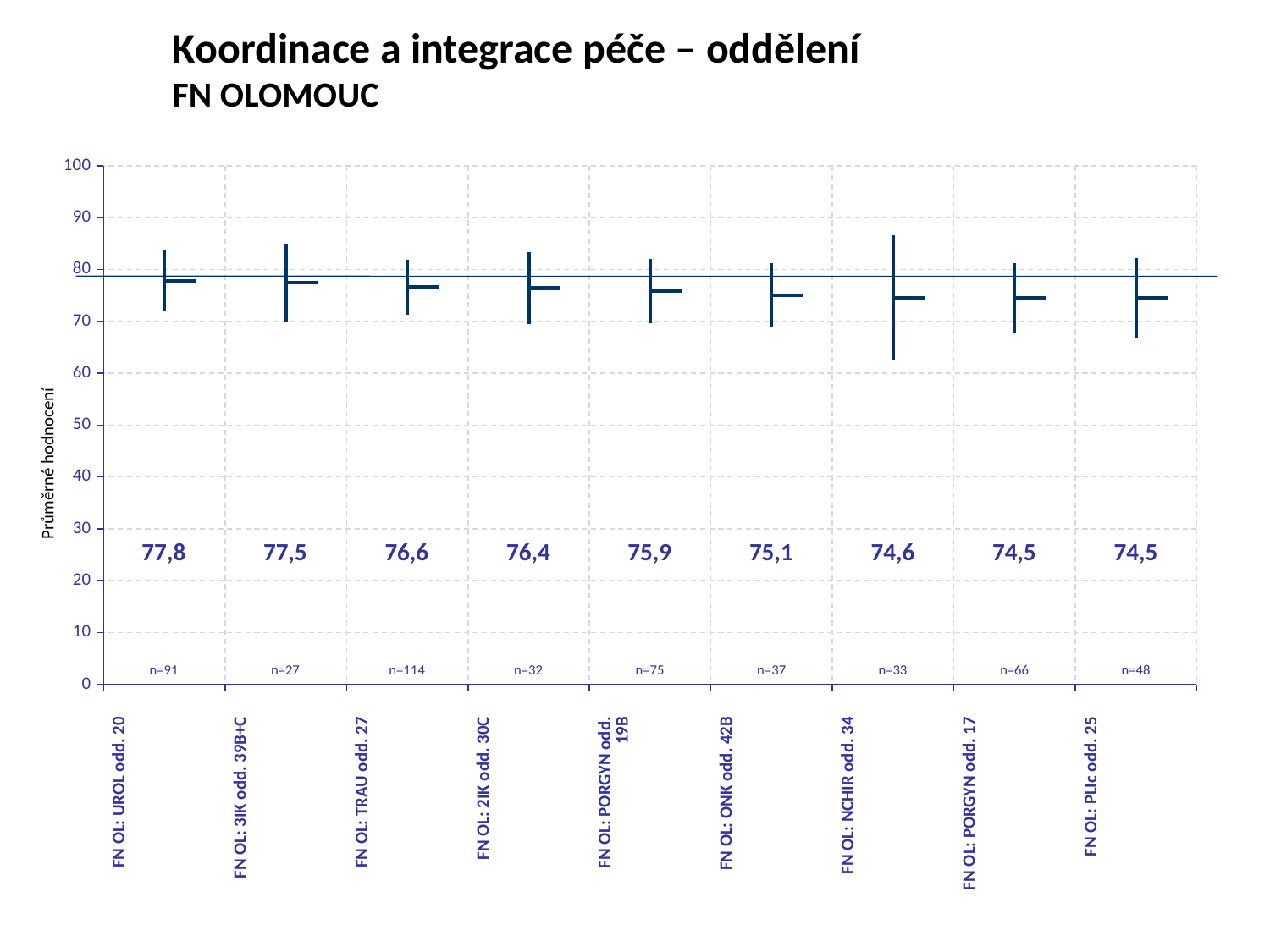
What is the title of the chart? Koordinace a integrace péče – oddělení FN OLOMOUC Which has a higher average rating, FN OL: 3IK odd. 39B+C or FN OL: PORGYN odd. 19B? FN OL: 3IK odd. 39B+C What is the average rating for FN OL: ONK odd. 42B? 75,1 What is the number of respondents (n) for FN OL: TRAU odd. 27? n=114 Is the average rating for FN OL: 2IK odd. 30C greater or less than 70? greater What is the average rating for FN OL: NCHIR odd. 34? 74,6 Which department has the highest average rating? FN OL: UROL odd. 20 How many departments are shown on the chart? 9 What is the label of the vertical axis? Průměrné hodnocení Do the average ratings rise or fall from left to right along the x axis? fall What is the average rating (průměrné hodnocení) for FN OL: UROL odd. 20? 77,8 What is the difference between the average ratings of FN OL: UROL odd. 20 and FN OL: PLIc odd. 25? 3,3